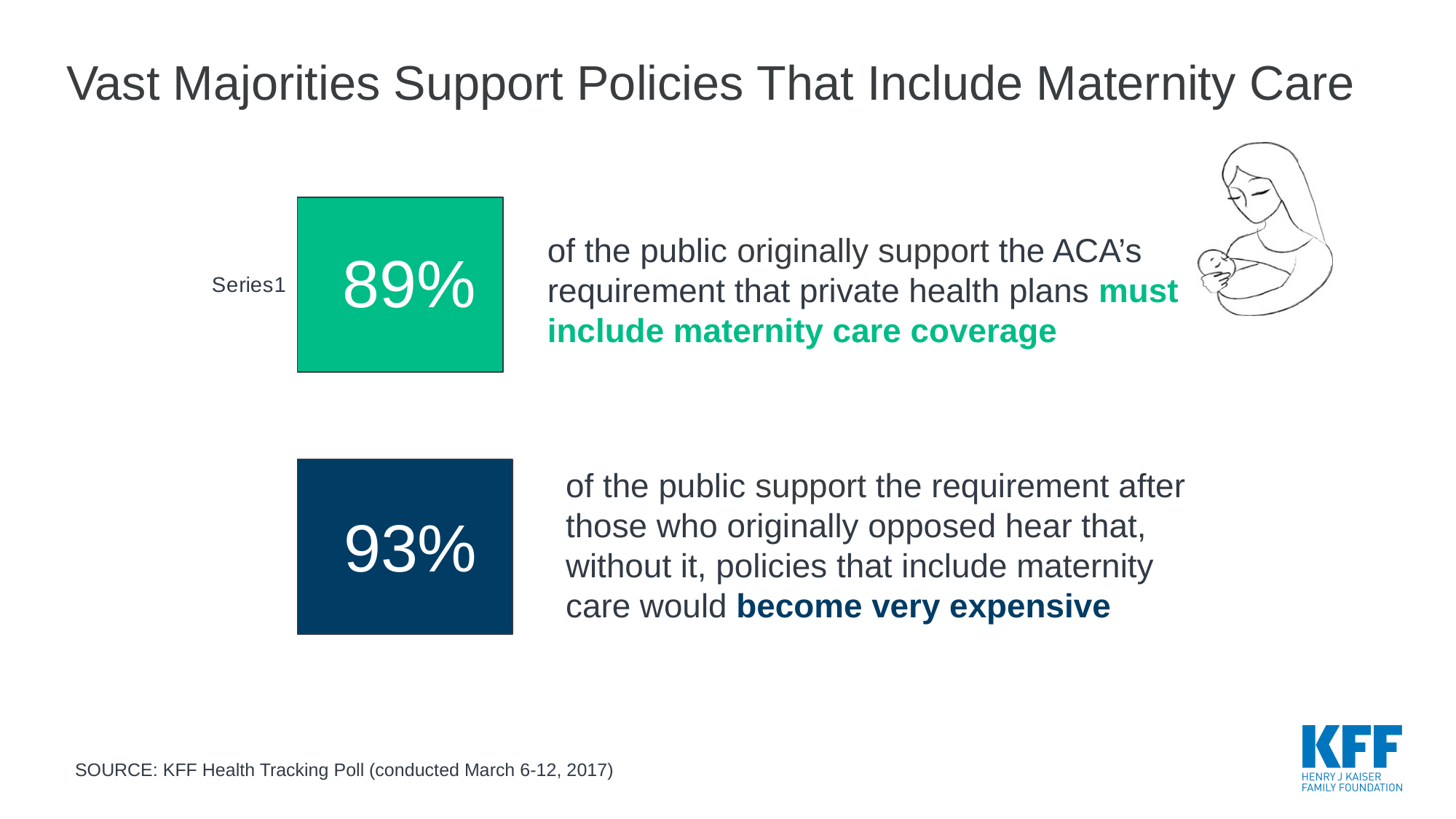
What colour is the box showing 93%? Dark blue What colour is the box showing 89%? Green Is the original support for the maternity care requirement greater or less than 80%? greater What percentage of the public support the requirement after those who originally opposed hear that, without it, policies that include maternity care would become very expensive? 93% Which of the two figures shown is the highest? 93% What is the title of the slide? Vast Majorities Support Policies That Include Maternity Care How many percentage figures are displayed on the slide? 2 Which value is larger: the original support for the maternity care requirement or the support after hearing that policies would become very expensive? 93% (after hearing policies would become very expensive) Which of the two figures shown is the lowest? 89% By how many percentage points does support for the requirement rise after opponents hear that policies would become very expensive? 4 percentage points What percentage of the public originally supported the ACA's requirement that private health plans must include maternity care coverage? 89%